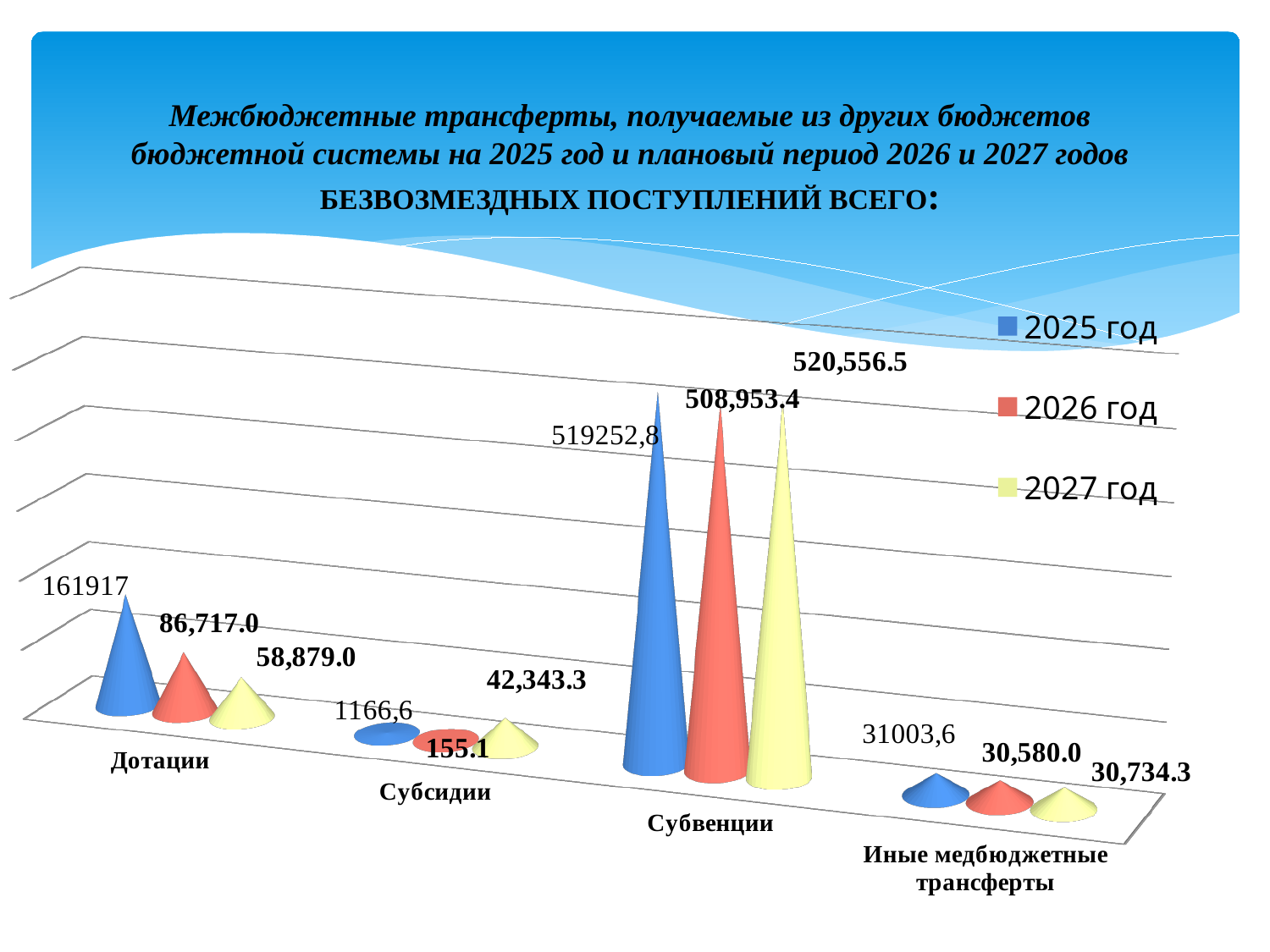
Which category has the highest value in the 2025 год series? Субвенции What is the difference between the 2026 год and 2027 год values for Дотации? 27,838.0 What kind of chart is shown on the slide? Bar chart What is the value for Субсидии in the 2026 год series? 155.1 How many series does the legend list? 3 What is the value for Субвенции in the 2027 год series? 520,556.5 What is the value for Иные межбюджетные трансферты in the 2026 год series? 30,580.0 Which category has the lowest value in the 2026 год series? Субсидии What is the value for Дотации in the 2025 год series? 161917 Do the values for Дотации rise or fall from 2025 год to 2027 год? Fall Which is larger for Дотации: the 2026 год value or the 2027 год value? 2026 год How many categories are shown on the x axis? 4